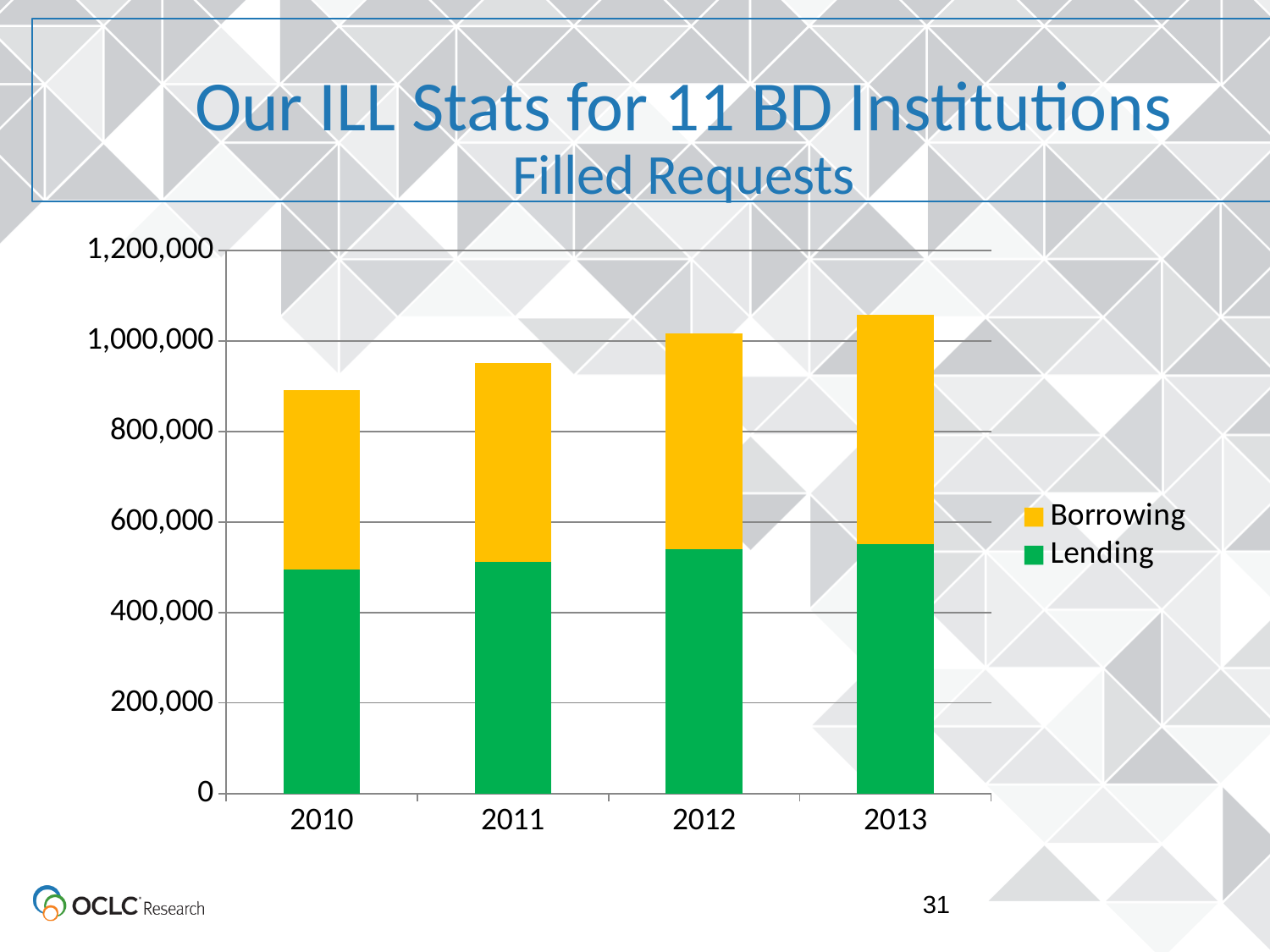
Is the Lending value for 2010 greater or less than 600,000? less Do the total filled requests rise or fall from 2010 to 2013? Rise What is the subtitle of the chart below the main title? Filled Requests How many years are shown on the x axis of the chart? 4 What kind of chart is shown on the slide? Stacked bar chart Which year has the highest total of filled requests? 2013 Which series is shown in green in the chart? Lending Is the total of filled requests for 2013 greater or less than 1,000,000? greater Is the total of filled requests for 2010 greater or less than 1,000,000? less How many series does the legend list? 2 Which year has the lowest total of filled requests? 2010